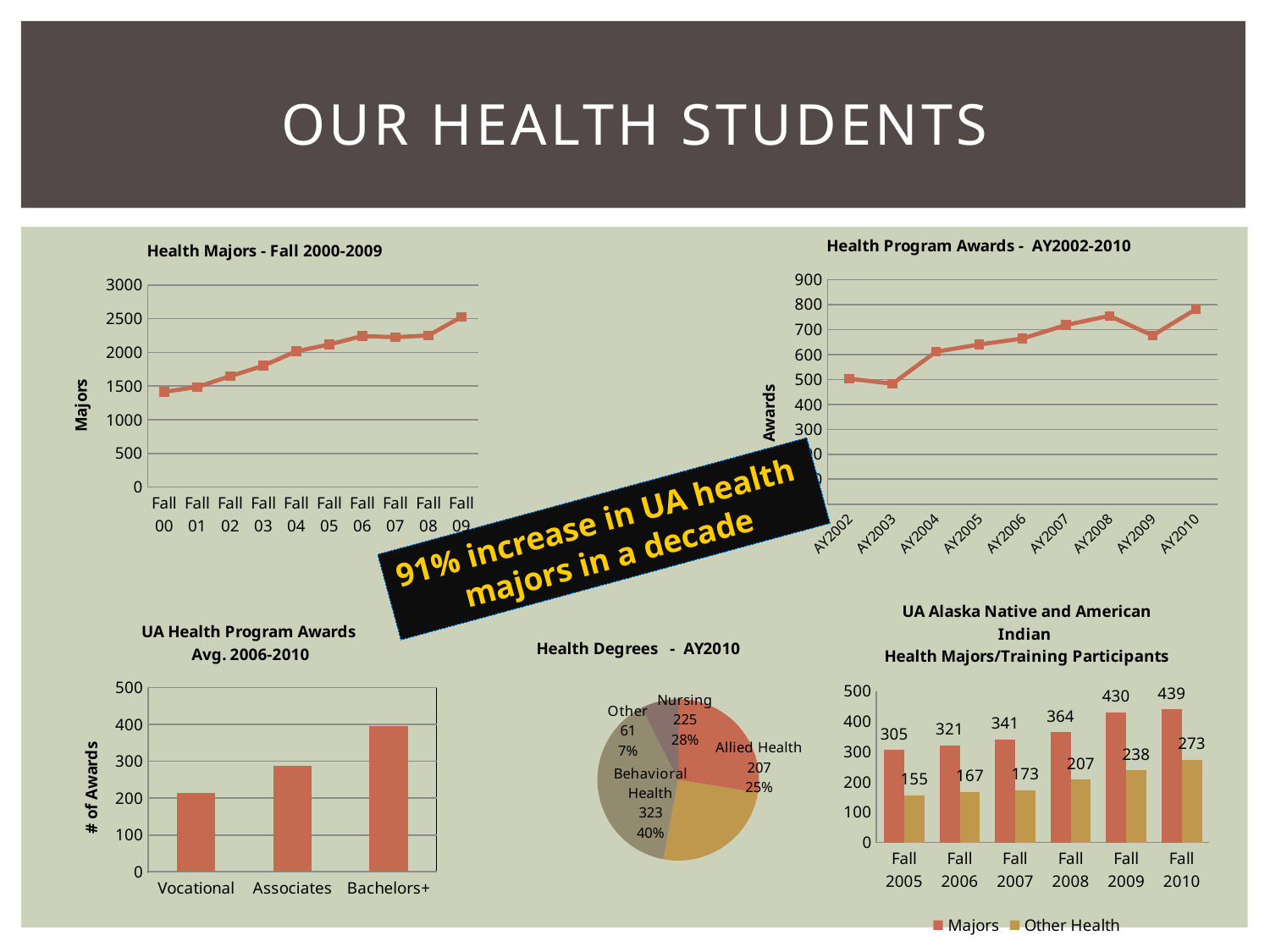
In the 'UA Alaska Native and American Indian Health Majors/Training Participants' chart, how many series does the legend list? 2 In the 'UA Alaska Native and American Indian Health Majors/Training Participants' chart, which year has the highest Other Health value? Fall 2010 In the 'Health Majors - Fall 2000-2009' chart, do the values generally rise or fall from Fall 00 to Fall 09? rise In the 'UA Alaska Native and American Indian Health Majors/Training Participants' chart, what is the difference between Majors and Other Health in Fall 2010? 166 In the 'Health Degrees - AY2010' pie chart, which category has the smallest slice? Other In the 'Health Degrees - AY2010' pie chart, what share of degrees was Nursing? 28% In the 'UA Health Program Awards Avg. 2006-2010' chart, is the value for Vocational greater or less than 200? greater What kind of chart is 'Health Program Awards - AY2002-2010'? line chart In the 'Health Program Awards - AY2002-2010' chart, is the value for AY2010 greater or less than 700? greater In the 'UA Health Program Awards Avg. 2006-2010' chart, which category has the highest number of awards? Bachelors+ In the 'Health Degrees - AY2010' pie chart, how many degrees were in Behavioral Health? 323 In the 'UA Alaska Native and American Indian Health Majors/Training Participants' chart, what is the value for Majors in Fall 2009? 430